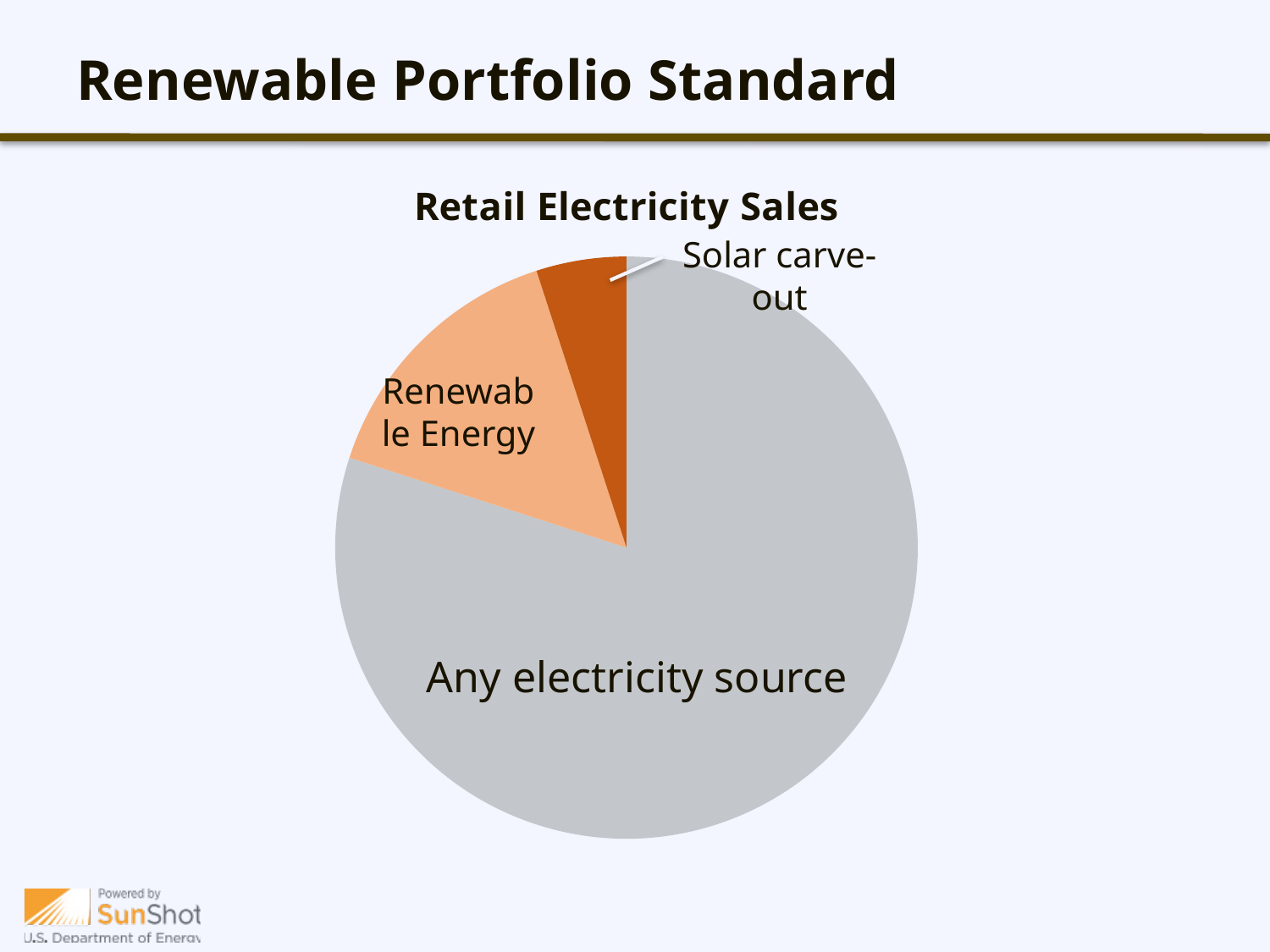
Which slice is larger, Any electricity source or Renewable Energy? Any electricity source Which slice of the pie chart is the smallest? Solar carve-out What kind of chart is shown on the slide? pie chart Which slice of the pie chart is the largest? Any electricity source What colour is the Solar carve-out slice? dark orange Which slice is larger, Renewable Energy or Solar carve-out? Renewable Energy Does the Any electricity source slice make up more or less than half of the pie? more What is the title of the chart? Retail Electricity Sales How many slices does the pie chart have? 3